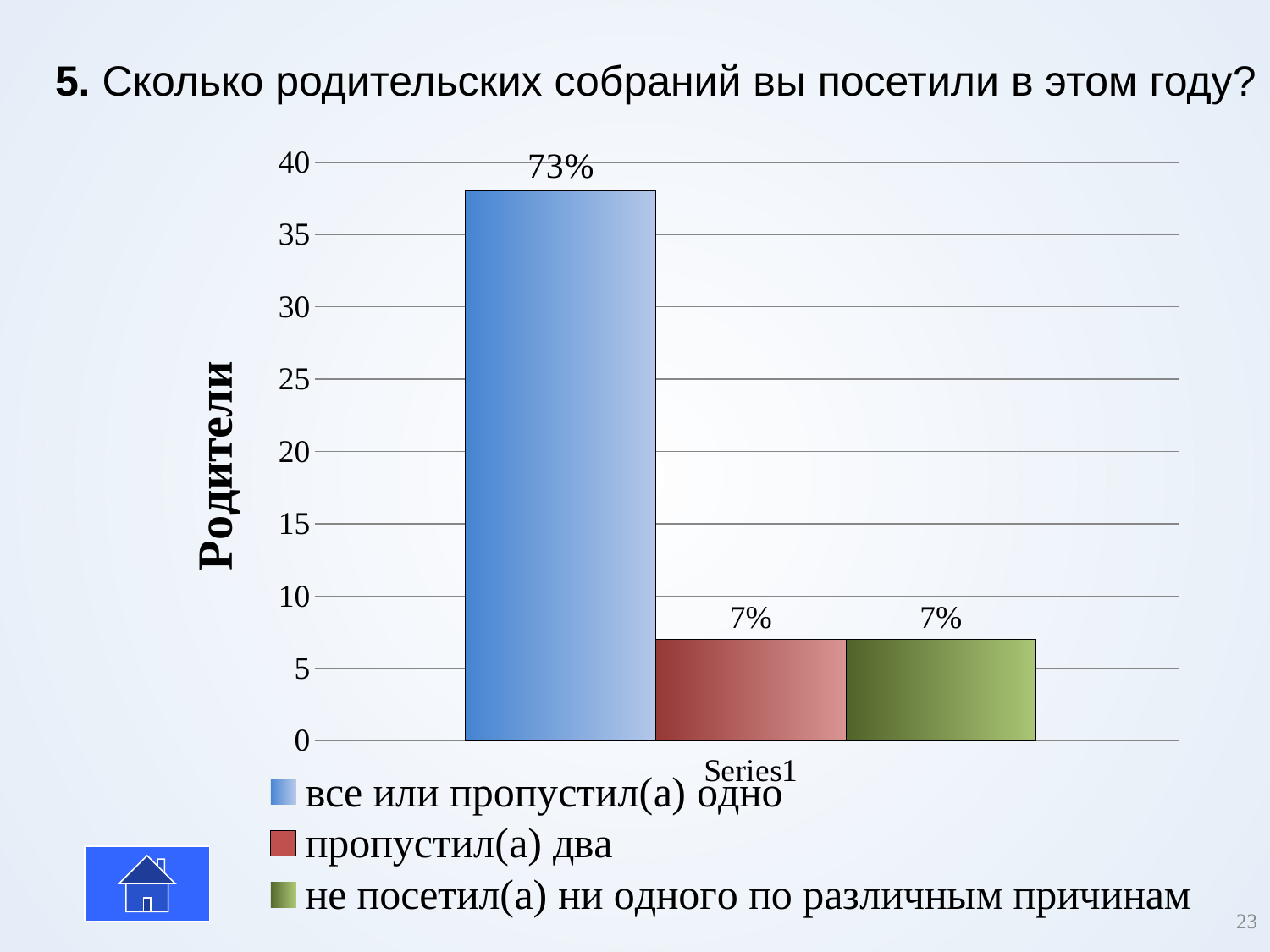
What kind of chart is shown on the slide? bar chart What colour is the bar for "не посетил(а) ни одного по различным причинам"? green What is the title of the vertical axis? Родители What data label is shown on the bar for "пропустил(а) два"? 7% What is the difference between the data labels for "все или пропустил(а) одно" and "пропустил(а) два"? 66% Which legend entry has the highest bar? все или пропустил(а) одно What data label is shown on the bar for "не посетил(а) ни одного по различным причинам"? 7% Is the bar for "пропустил(а) два" greater or less than 10 on the vertical axis? less Which is larger: the bar for "все или пропустил(а) одно" or the bar for "пропустил(а) два"? все или пропустил(а) одно What data label is shown on the bar for "все или пропустил(а) одно"? 73% How many series does the legend list? 3 Is the bar for "все или пропустил(а) одно" greater or less than 35 on the vertical axis? greater